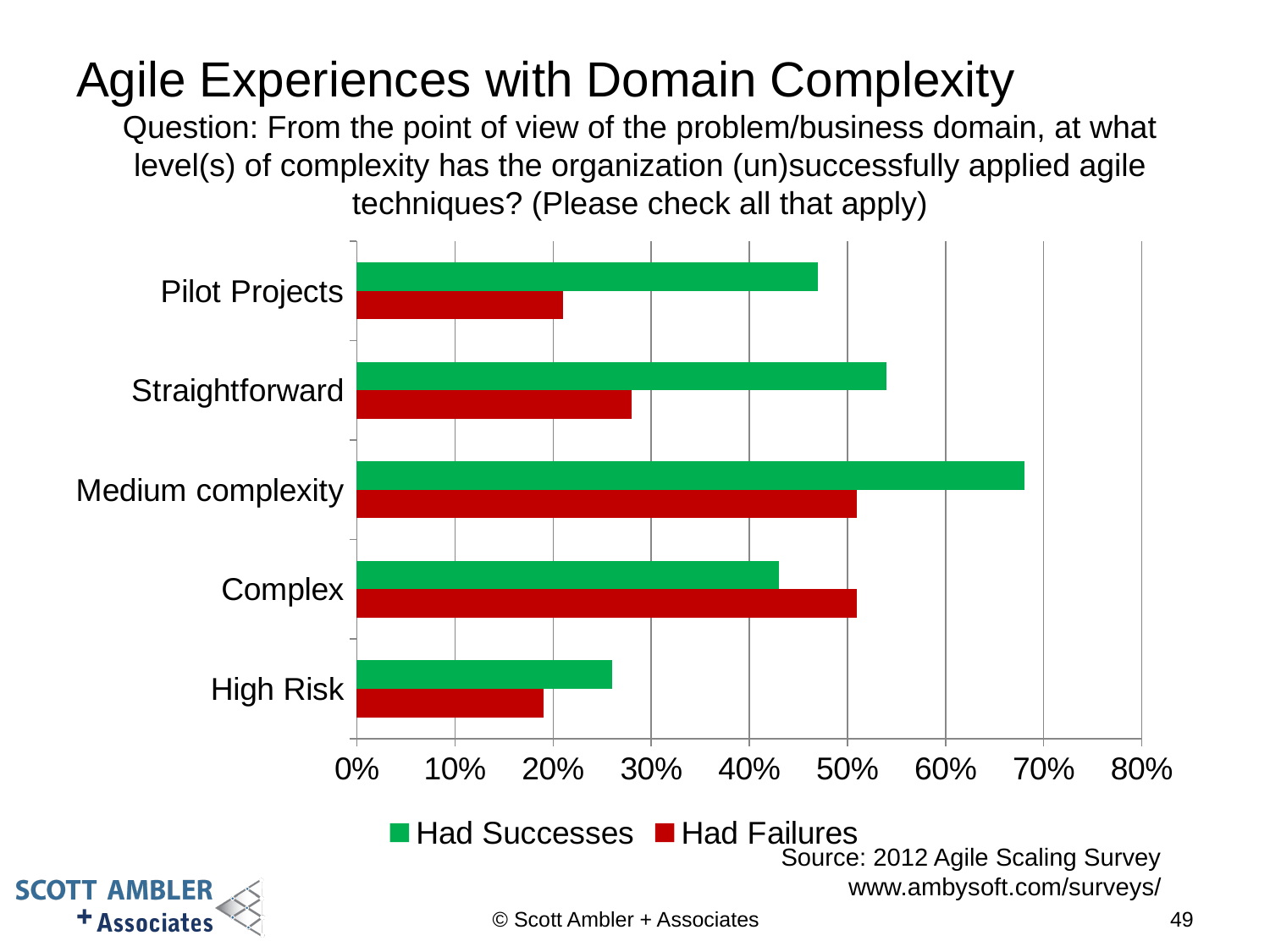
Which category has the lowest value for Had Successes? High Risk How many series does the legend list? 2 Is the Had Failures value for Straightforward greater or less than 30%? less For Complex, which is larger: Had Successes or Had Failures? Had Failures Is the Had Successes value for Straightforward greater or less than 50%? greater Is the Had Successes value for Medium complexity greater or less than 60%? greater What colour are the Had Failures bars? red For Pilot Projects, which is larger: Had Successes or Had Failures? Had Successes How many complexity categories are plotted on the chart? 5 What kind of chart is shown on the slide? bar chart Which category has the highest value for Had Successes? Medium complexity